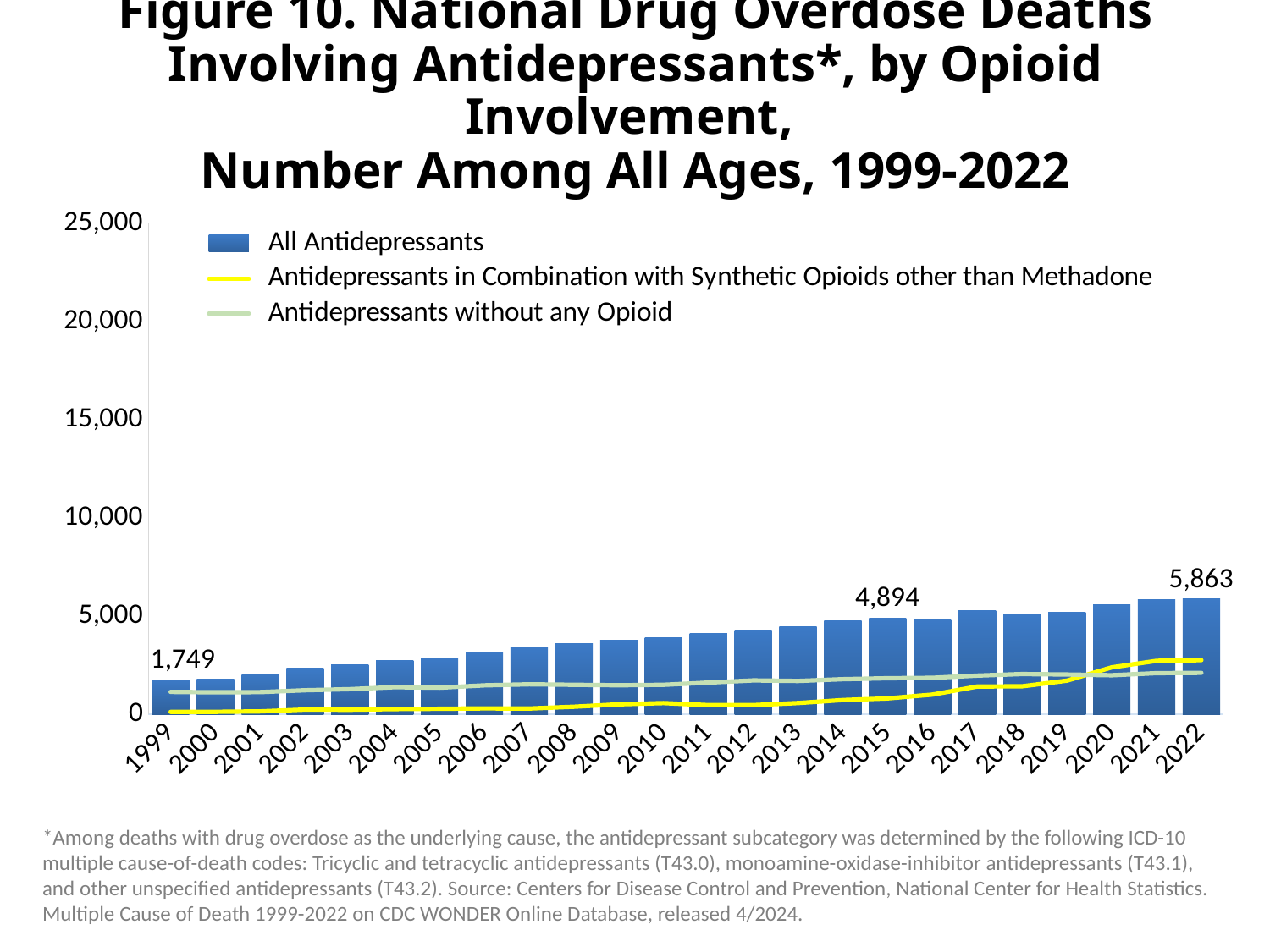
What is the value for All Antidepressants in 2015? 4,894 How many years are shown on the x axis? 24 Do the All Antidepressants values rise or fall from 1999 to 2022? rise What is the value for All Antidepressants in 1999? 1,749 What is the difference between the All Antidepressants values for 2022 and 2015? 969 What is the difference between the All Antidepressants values for 2022 and 1999? 4,114 What kind of chart is used to show the All Antidepressants series? bar chart How many series does the legend list? 3 Which year has the highest number of All Antidepressants deaths? 2022 What is the value for All Antidepressants in 2022? 5,863 Is the All Antidepressants value for 2005 greater or less than 5,000? less Which year has the lowest number of All Antidepressants deaths? 1999